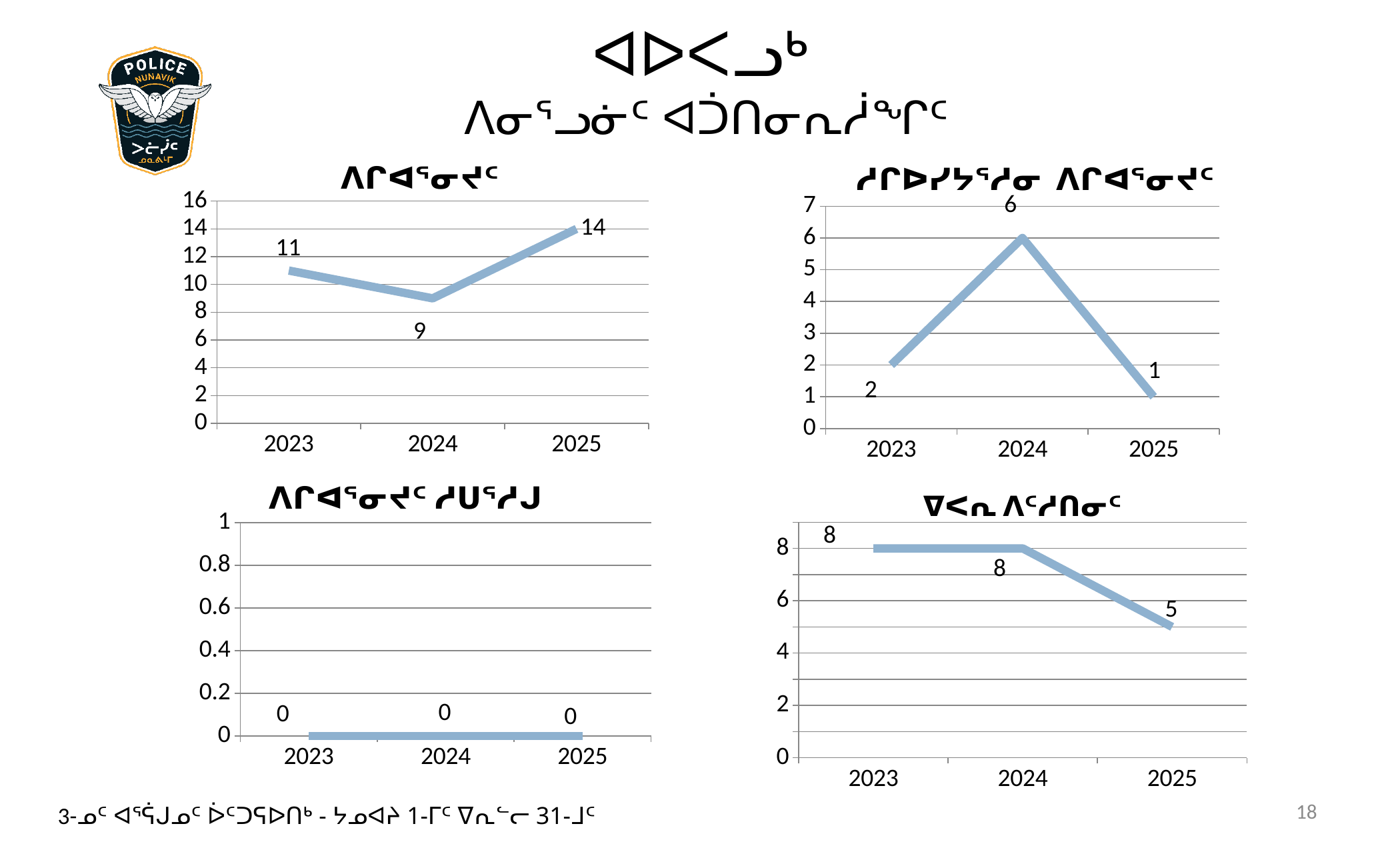
What kind of chart is the top-left chart? line chart In the bottom-right chart, what is the difference between the 2023 and 2025 values? 3 In the bottom-left chart, what is the value for 2024? 0 In the top-left chart, what is the value for 2025? 14 In the top-left chart, which year has the lowest value? 2024 In the top-left chart, what is the difference between the 2025 and 2024 values? 5 How many data points are plotted in the bottom-left chart? 3 In the top-right chart, which is larger, the value for 2023 or the value for 2025? 2023 In the top-right chart, what is the value for 2024? 6 In the top-right chart, which year has the highest value? 2024 In the bottom-right chart, do the values rise or fall from 2024 to 2025? fall In the bottom-right chart, what is the value for 2025? 5